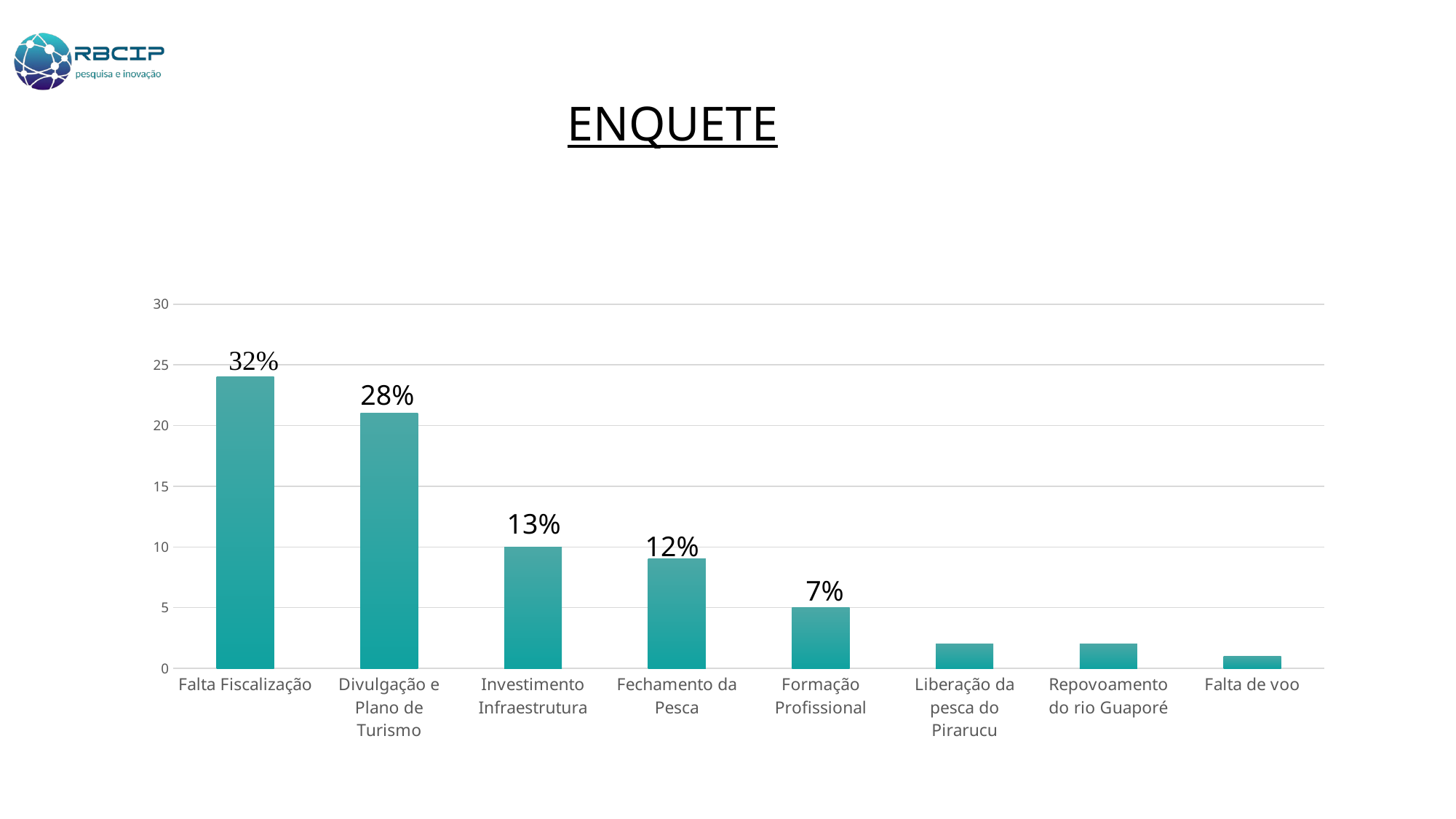
How many categories are shown on the x axis? 8 Is the bar for Falta Fiscalização greater or less than 20 on the axis? greater What data label is shown on the bar for Falta Fiscalização? 32% Do the bar values rise or fall from left to right along the x axis? fall Which has the larger labelled value, Investimento Infraestrutura or Fechamento da Pesca? Investimento Infraestrutura Is the bar for Liberação da pesca do Pirarucu greater or less than 5 on the axis? less What kind of chart is shown on the slide? bar chart What is the difference between the labelled percentages for Falta Fiscalização and Divulgação e Plano de Turismo? 4% What data label is shown on the bar for Formação Profissional? 7% What data label is shown on the bar for Divulgação e Plano de Turismo? 28% Which category has the lowest bar? Falta de voo Which category has the highest bar? Falta Fiscalização